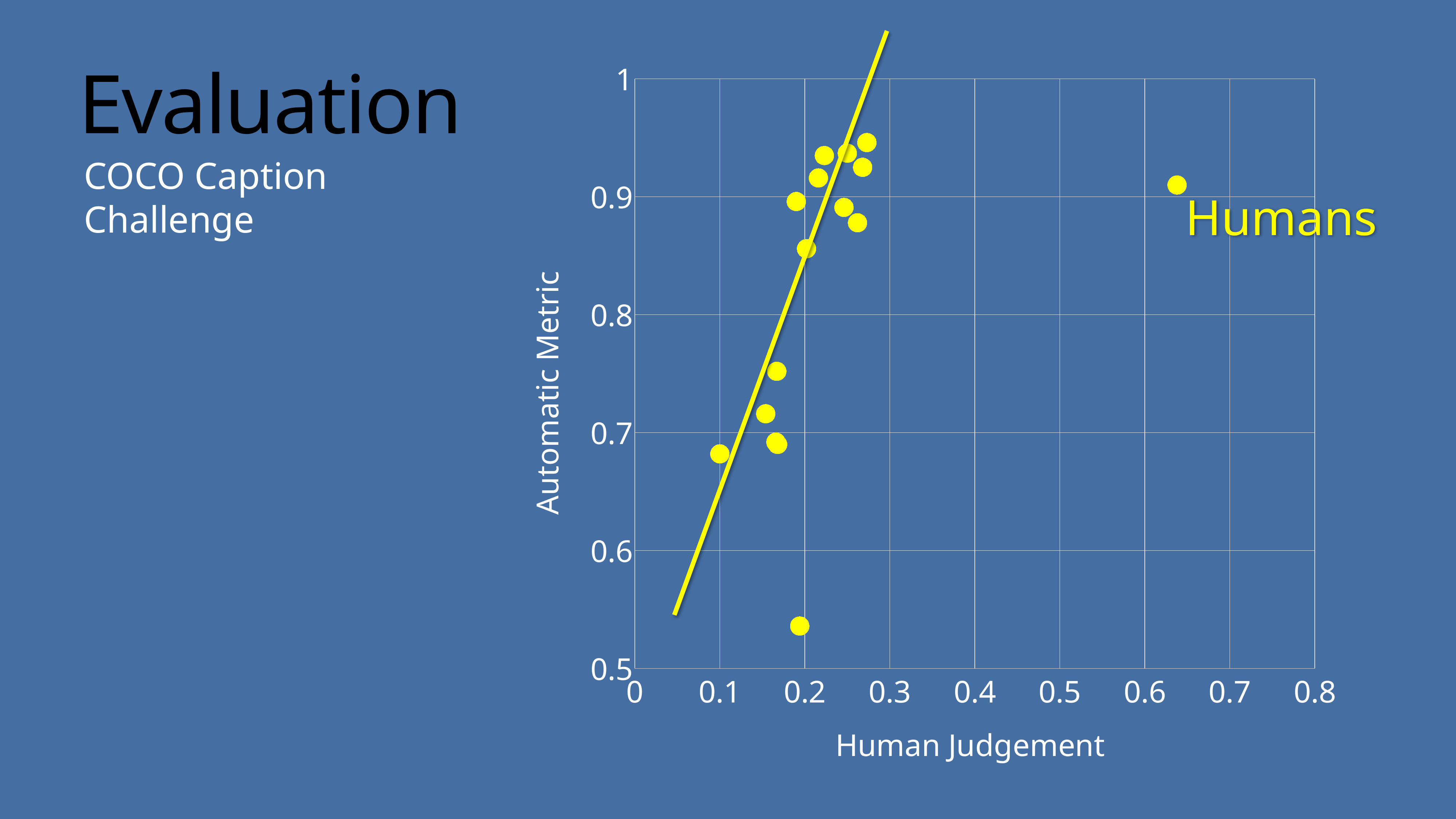
What kind of chart is shown on the slide? scatter chart Is the Automatic Metric value of the lowest point on the chart greater or less than 0.6? less What is the label of the x axis of the chart? Human Judgement Is the Automatic Metric value for the Humans point greater or less than 0.8? greater Is the Human Judgement value for the Humans point greater or less than 0.6? greater What is the label of the y axis of the chart? Automatic Metric Which labelled point has the highest Human Judgement value? Humans Does the fitted trend line rise or fall as Human Judgement increases? rises